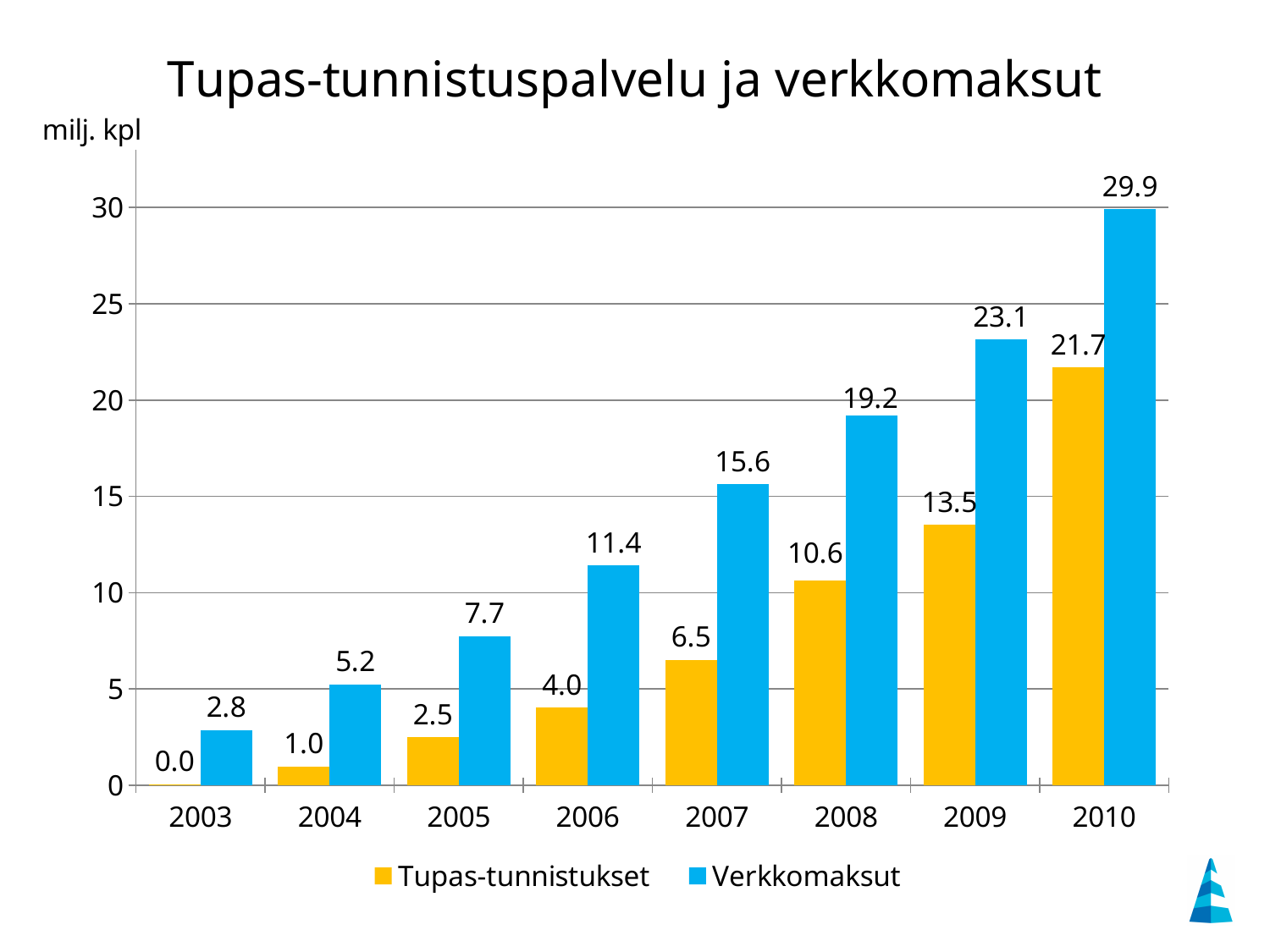
Do the Verkkomaksut values rise or fall from 2003 to 2010? Rise What kind of chart is shown on the slide? Bar chart What is the difference between Verkkomaksut and Tupas-tunnistukset in 2009? 9.6 Which year has the highest value for Verkkomaksut? 2010 How many years are shown on the x axis? 8 What is the value for Verkkomaksut in 2010? 29.9 What unit is shown above the y axis? milj. kpl What is the value for Tupas-tunnistukset in 2008? 10.6 Which year has the lowest value for Tupas-tunnistukset? 2003 What is the value for Tupas-tunnistukset in 2003? 0.0 Which is larger in 2006, Tupas-tunnistukset or Verkkomaksut? Verkkomaksut How many series does the legend list? 2